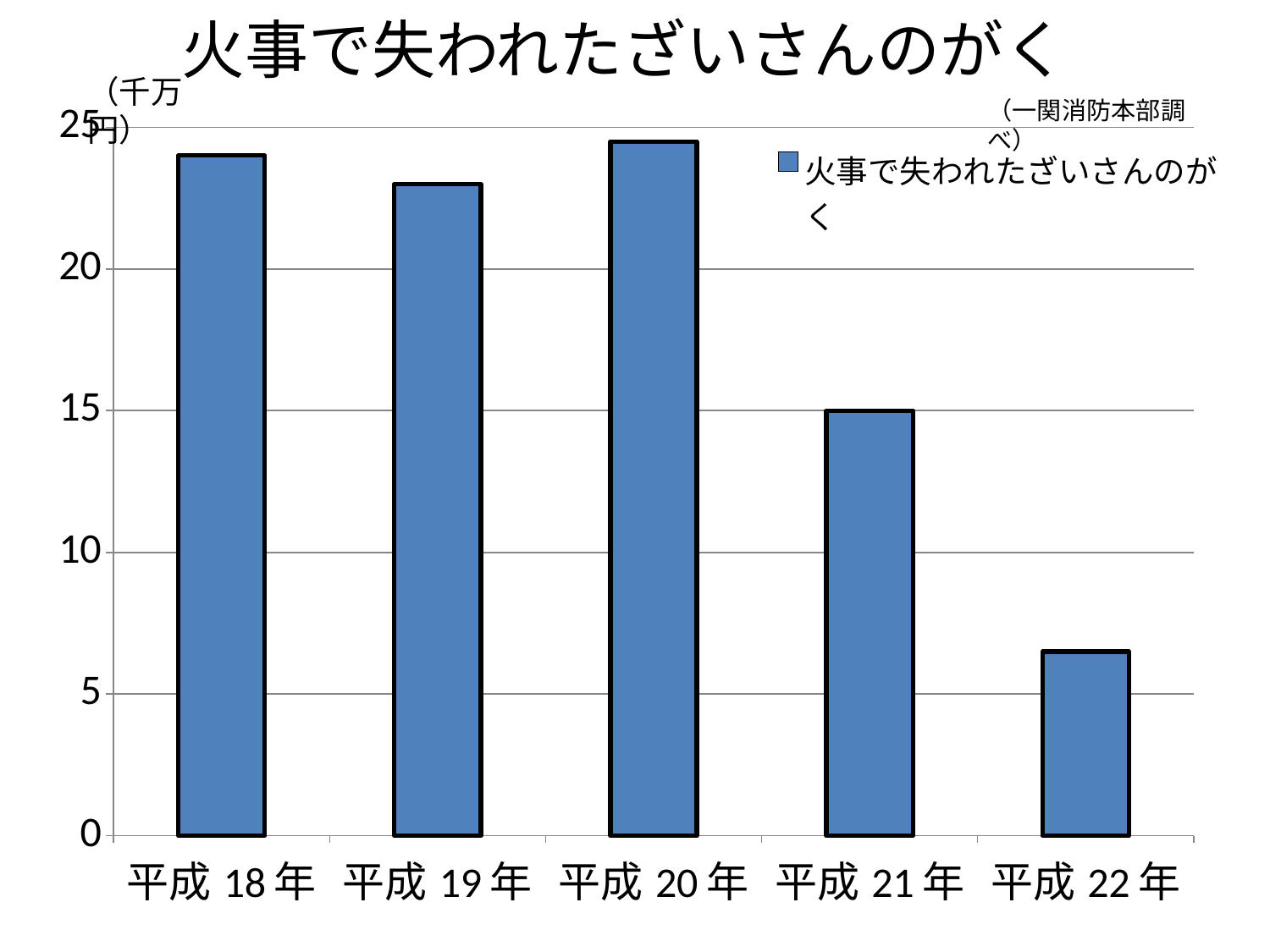
What is the title of the chart? 火事で失われたざいさんのがく Is the value for 平成22年 greater or less than 10? less How many categories (years) are shown on the x axis? 5 Is the value for 平成20年 greater or less than 20? greater Is the value for 平成19年 greater or less than 20? greater Which year has the lowest value? 平成22年 How many series does the legend list? 1 What kind of chart is shown on the slide? bar chart Which is larger, the value for 平成18年 or the value for 平成21年? 平成18年 What is the value for 平成21年? 15 Do the values generally rise or fall from 平成18年 to 平成22年? fall